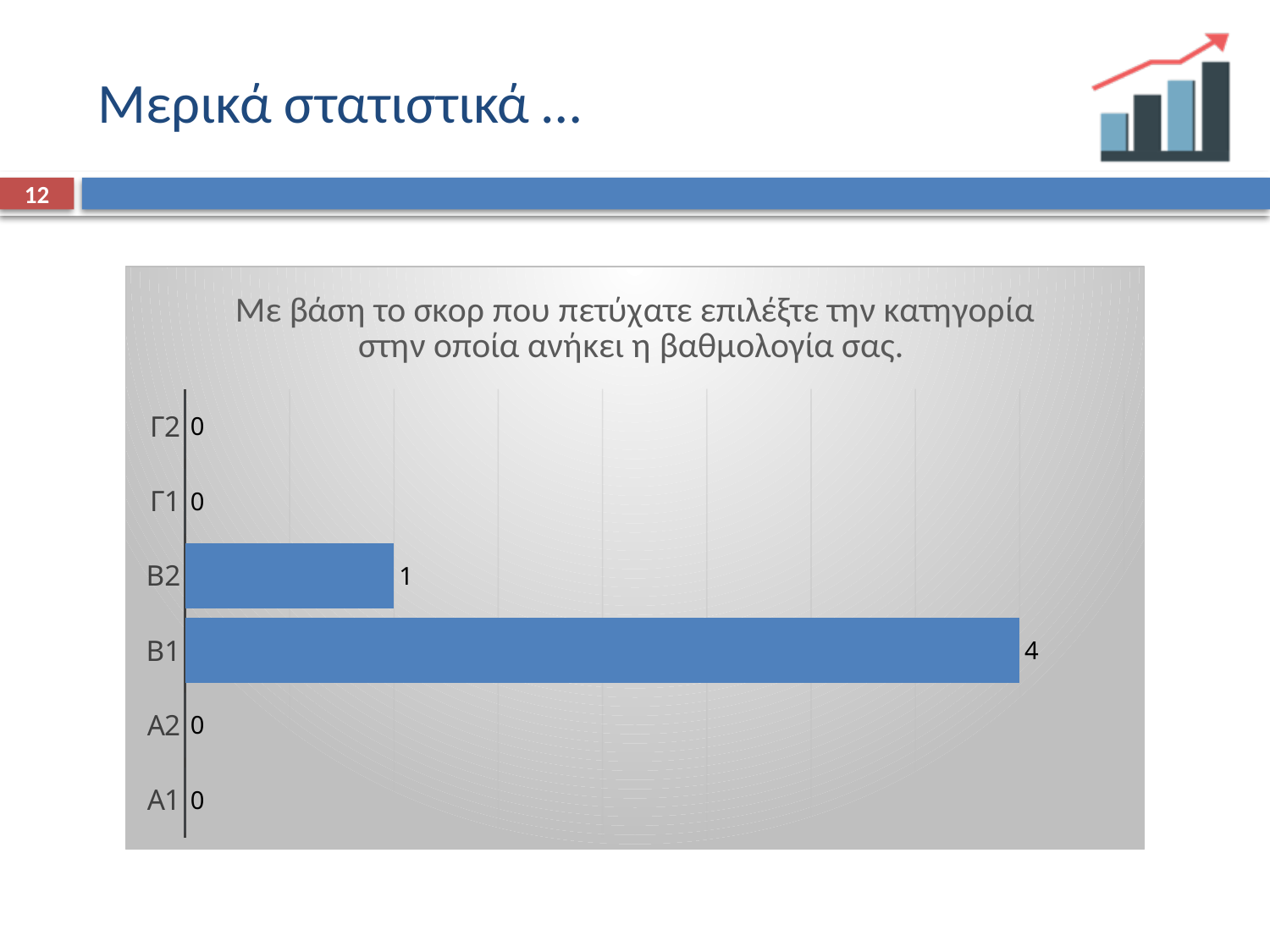
What is the value for B2? 1 How many categories are shown on the chart? 6 What colour are the bars in the chart? blue How many categories have a value of 0? 4 What kind of chart is shown on the slide? bar chart What is the value for B1? 4 What is the title of the chart? Με βάση το σκορ που πετύχατε επιλέξτε την κατηγορία στην οποία ανήκει η βαθμολογία σας. What is the value for Γ2? 0 Which is larger, the value for B1 or the value for B2? B1 What is the value for A1? 0 What is the difference between the values for B1 and B2? 3 Which category has the highest value? B1